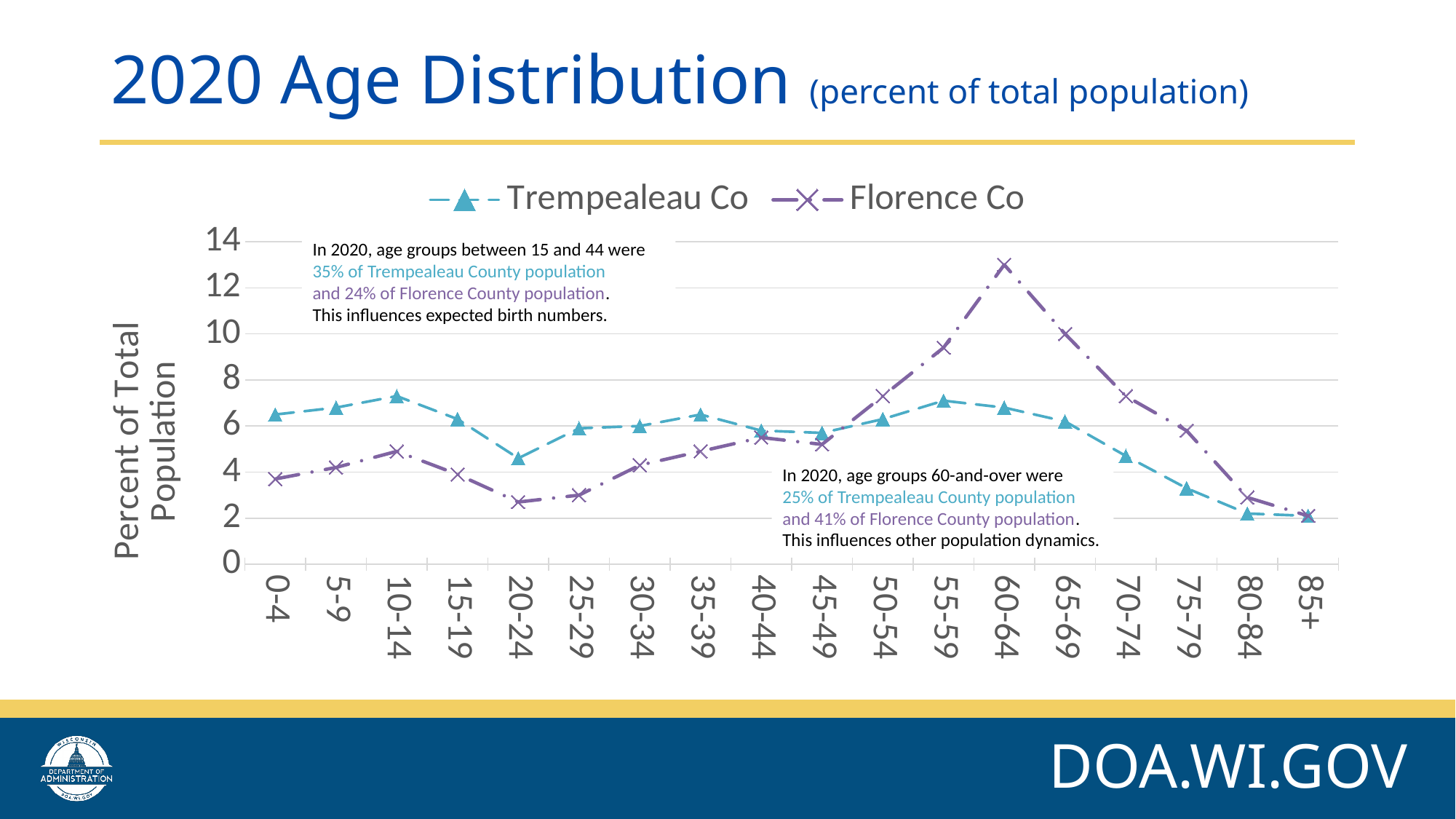
In the 10-14 age group, which county has the larger value? Trempealeau Co How many age groups are shown on the x axis? 18 Which age group has the lowest value for Florence Co? 85+ Do the Florence Co values rise or fall from the 60-64 age group to the 85+ age group? Fall What is the title of the chart on the slide? 2020 Age Distribution (percent of total population) What kind of chart is shown on the slide? Line chart Is the value for Florence Co in the 20-24 age group greater or less than 4? less Is the value for Trempealeau Co in the 10-14 age group greater or less than 6? greater In the 60-64 age group, which county has the larger value? Florence Co Is the value for Florence Co in the 60-64 age group greater or less than 12? greater How many series does the legend list? 2 Which age group has the highest value for Florence Co? 60-64